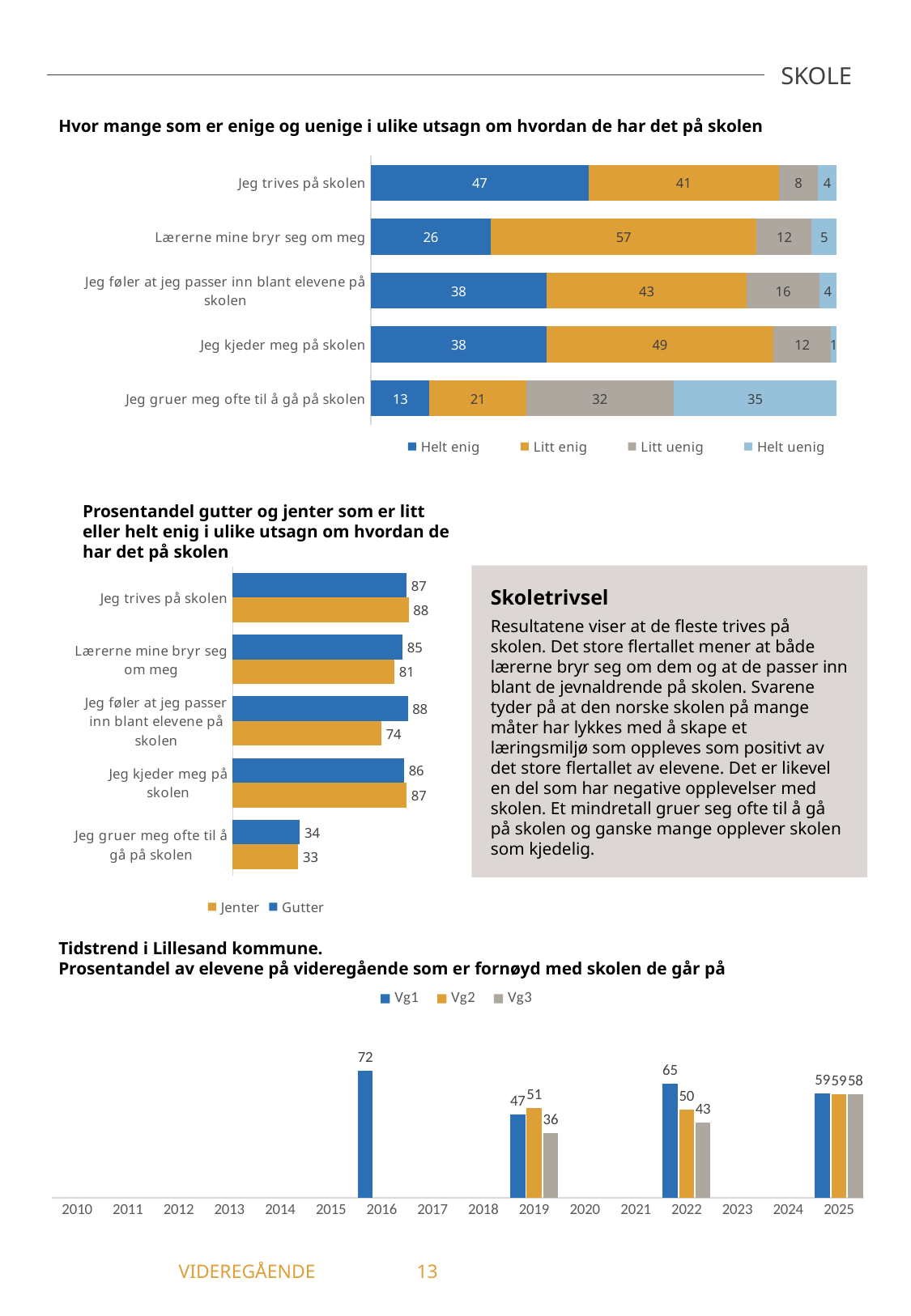
In the chart 'Hvor mange som er enige og uenige i ulike utsagn om hvordan de har det på skolen', which statement has the highest 'Litt enig' value? Lærerne mine bryr seg om meg In the chart 'Tidstrend i Lillesand kommune', what is the Vg1 value for 2016? 72 In the chart 'Prosentandel gutter og jenter som er litt eller helt enig i ulike utsagn om hvordan de har det på skolen', what is the Jenter value for 'Jeg føler at jeg passer inn blant elevene på skolen'? 74 What kind of chart is 'Tidstrend i Lillesand kommune'? Bar chart In the chart 'Prosentandel gutter og jenter som er litt eller helt enig i ulike utsagn om hvordan de har det på skolen', what is the difference between Gutter and Jenter for 'Jeg føler at jeg passer inn blant elevene på skolen'? 14 In the chart 'Tidstrend i Lillesand kommune', which is larger in 2022: Vg2 or Vg3? Vg2 In the chart 'Prosentandel gutter og jenter som er litt eller helt enig i ulike utsagn om hvordan de har det på skolen', which statement has the lowest Gutter value? Jeg gruer meg ofte til å gå på skolen In the chart 'Hvor mange som er enige og uenige i ulike utsagn om hvordan de har det på skolen', what is the total of the stacked bar for 'Lærerne mine bryr seg om meg'? 100 In the chart 'Hvor mange som er enige og uenige i ulike utsagn om hvordan de har det på skolen', what is the 'Helt enig' value for 'Jeg trives på skolen'? 47 In the chart 'Hvor mange som er enige og uenige i ulike utsagn om hvordan de har det på skolen', what is the 'Helt uenig' value for 'Jeg gruer meg ofte til å gå på skolen'? 35 In the chart 'Hvor mange som er enige og uenige i ulike utsagn om hvordan de har det på skolen', how many series does the legend list? 4 In the chart 'Prosentandel gutter og jenter som er litt eller helt enig i ulike utsagn om hvordan de har det på skolen', how many statements are shown? 5